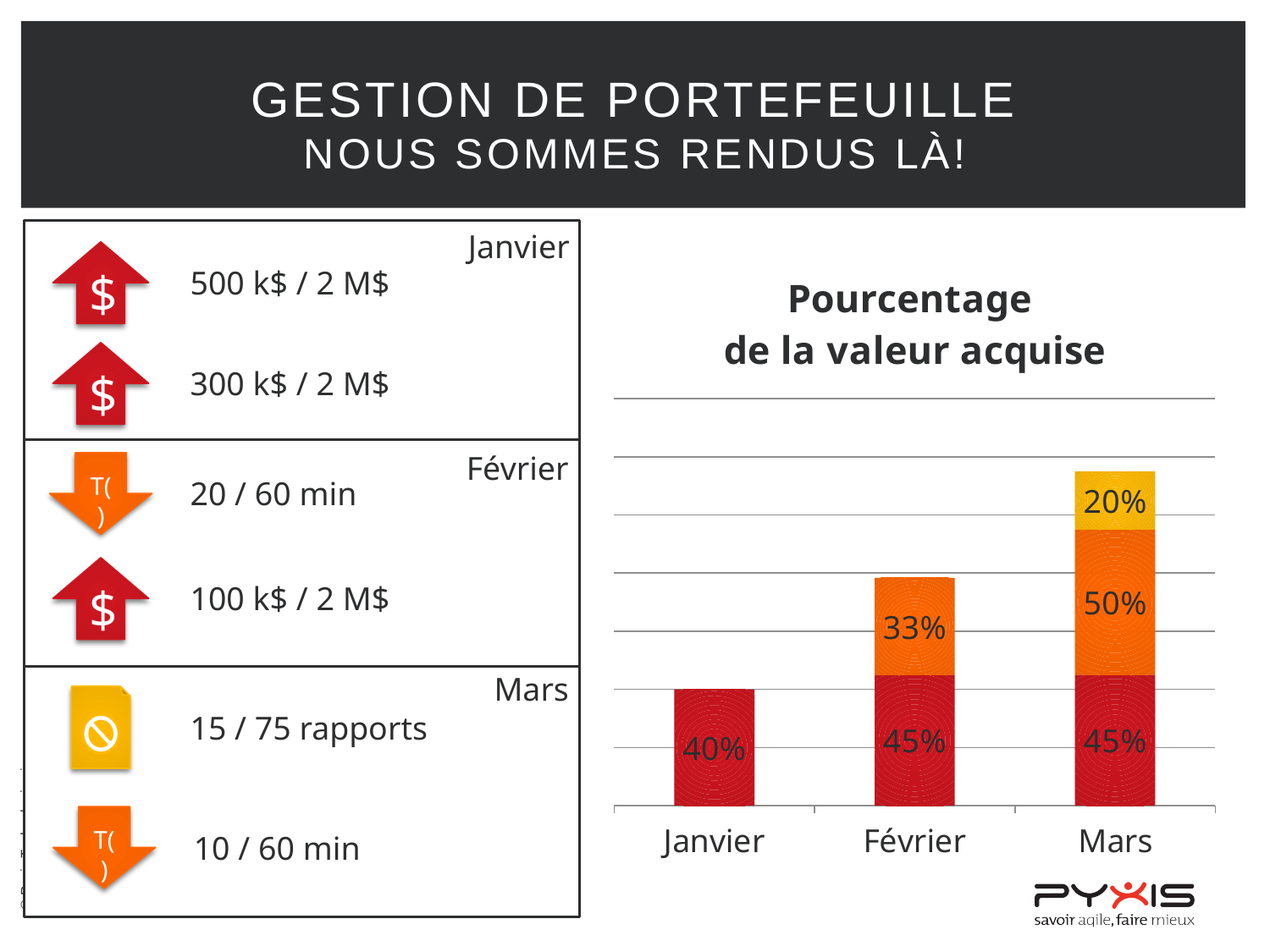
How many categories are shown on the x axis of the chart? 3 What is the difference between the orange segment for Mars and the orange segment for Février? 17% What kind of chart is shown on the slide? stacked bar chart What is the value of the orange segment for Mars? 50% What is the total of the stacked bar for Février? 78% What is the value of the orange segment for Février? 33% What is the value of the yellow segment for Mars? 20% What is the value of the red segment for Janvier? 40% What is the value of the red segment for Février? 45% Which month has the shortest stacked bar? Janvier Which month has the tallest stacked bar? Mars What is the title of the chart? Pourcentage de la valeur acquise